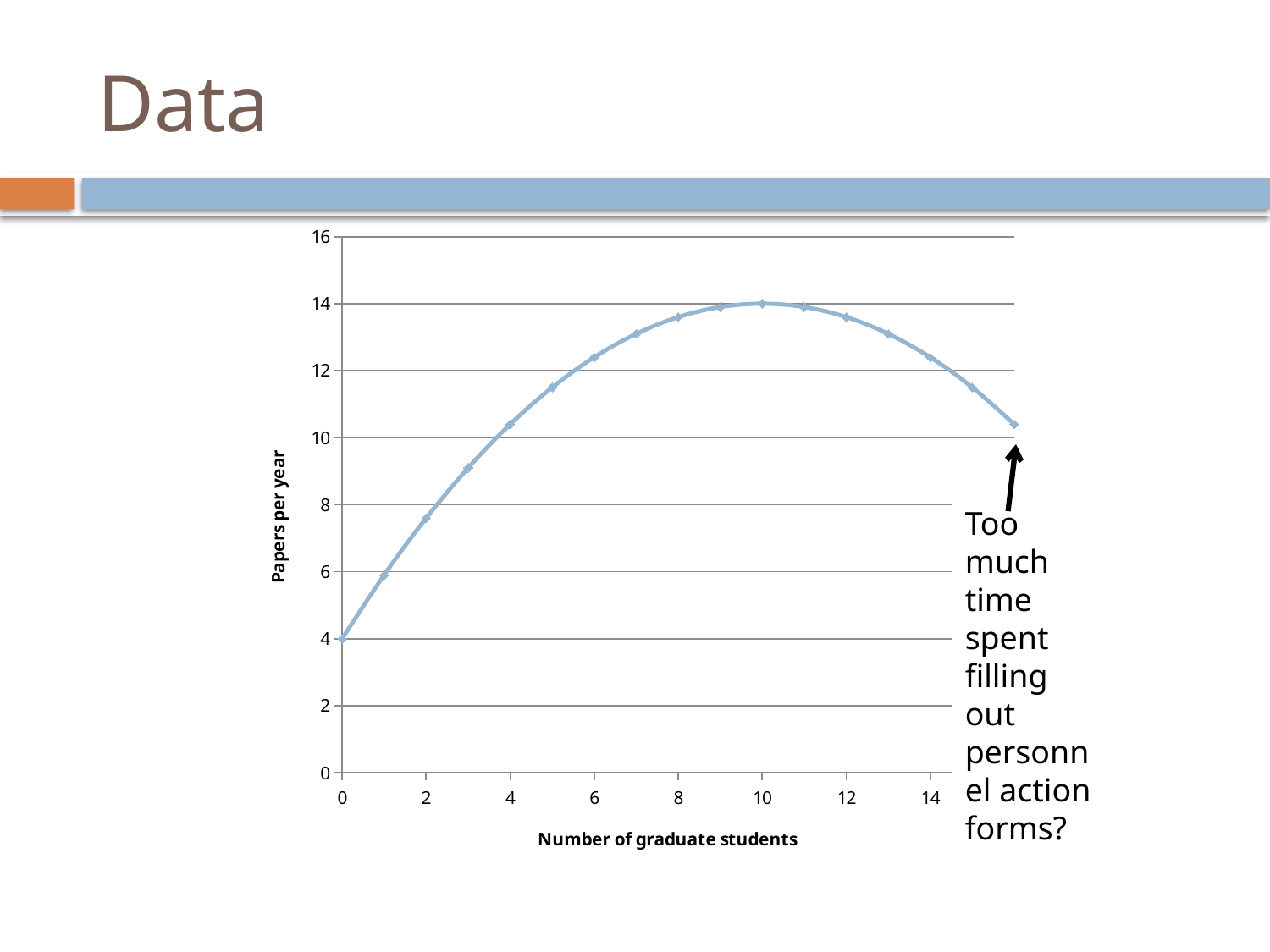
Is the value for 14 graduate students greater or less than 12 papers per year? greater At how many graduate students does the number of papers per year reach its highest value? 10 What kind of chart is shown on the slide? line chart Is the value for 3 graduate students greater or less than 8 papers per year? greater What is the difference in papers per year between 10 graduate students and 0 graduate students? 10 Which has more papers per year: 2 graduate students or 12 graduate students? 12 graduate students Is the value for 2 graduate students greater or less than 8 papers per year? less Do papers per year rise or fall as the number of graduate students increases from 10 to 16? fall What is the label on the vertical axis of the chart? Papers per year How many papers per year are produced with 10 graduate students? 14 At how many graduate students is the number of papers per year lowest? 0 How many papers per year are produced with 0 graduate students? 4